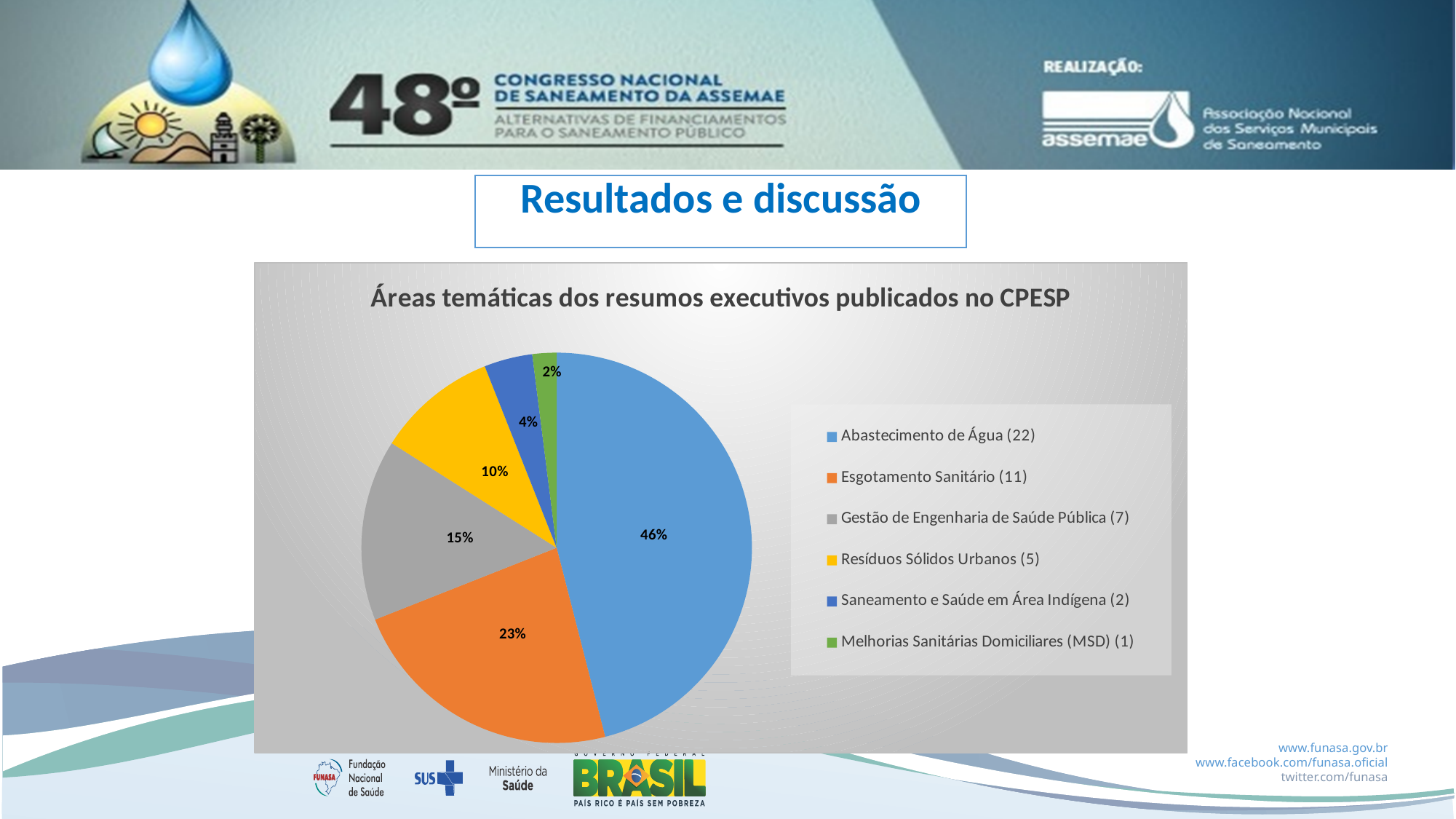
What is the title of the chart? Áreas temáticas dos resumos executivos publicados no CPESP What percentage share does Resíduos Sólidos Urbanos have in the pie chart? 10% What is the difference in percentage points between the Abastecimento de Água slice and the Esgotamento Sanitário slice? 23 What percentage share does Gestão de Engenharia de Saúde Pública have in the pie chart? 15% Which category has the largest slice of the pie chart? Abastecimento de Água What percentage share does Saneamento e Saúde em Área Indígena have in the pie chart? 4% Which category has the smallest slice of the pie chart? Melhorias Sanitárias Domiciliares (MSD) Which slice is larger: Resíduos Sólidos Urbanos or Gestão de Engenharia de Saúde Pública? Gestão de Engenharia de Saúde Pública How many categories does the legend of the pie chart list? 6 What kind of chart is shown on the slide? pie chart